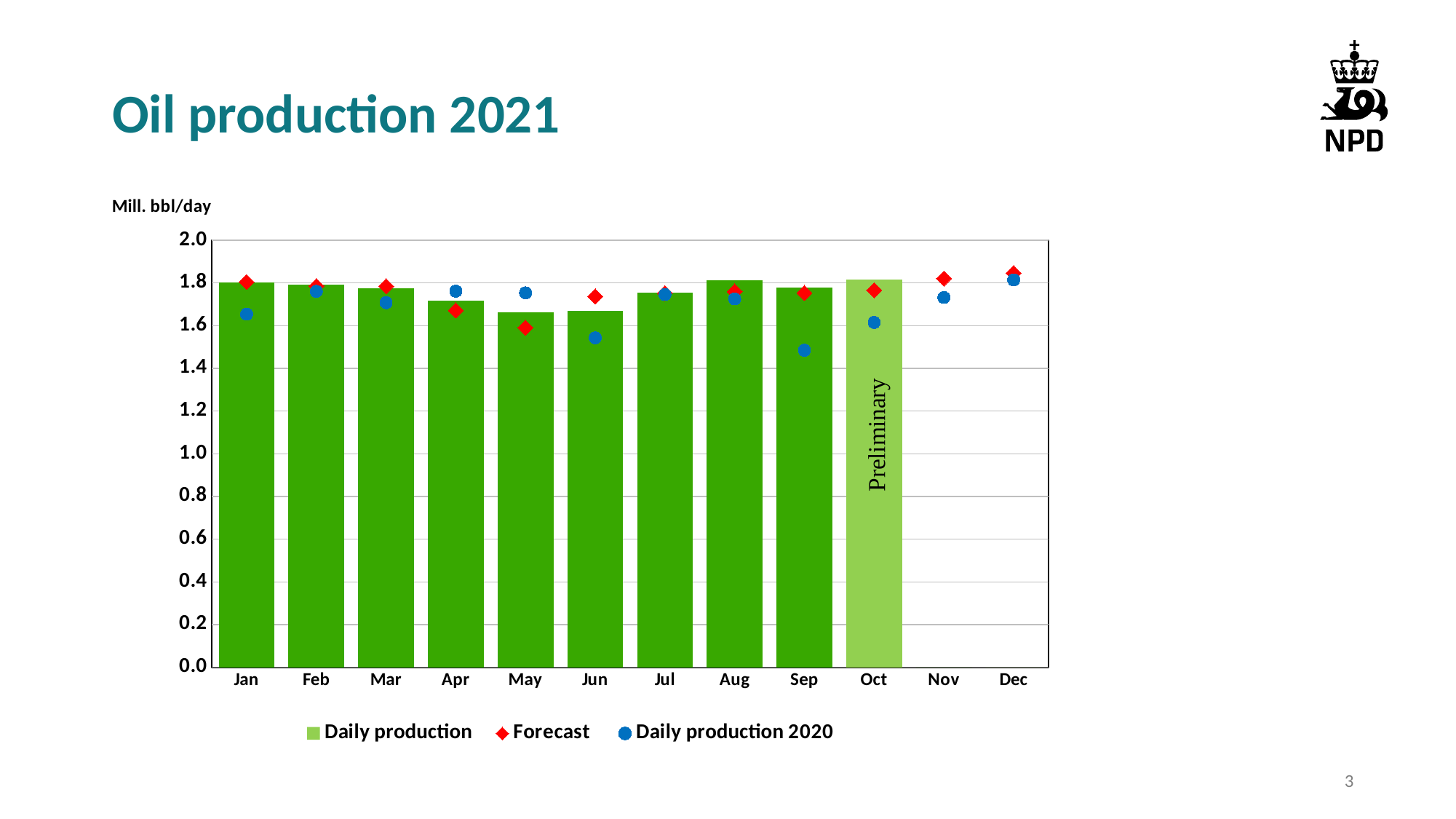
How many months are shown on the x axis? 12 What kind of chart is shown on the slide? Bar chart How many months have a Daily production bar plotted? 10 Which month has the lowest Forecast value? May Is the Daily production 2020 value for Jun greater or less than 1.6? less In Sep, which is larger: Daily production or Daily production 2020? Daily production How many series does the legend list? 3 Which month has the highest Daily production 2020 value? Dec In Jun, which is larger: Forecast or Daily production? Forecast Which month's Daily production bar is labelled 'Preliminary'? Oct Is the Daily production value for Jan greater or less than 1.6? greater Which month has the lowest Daily production 2020 value? Sep